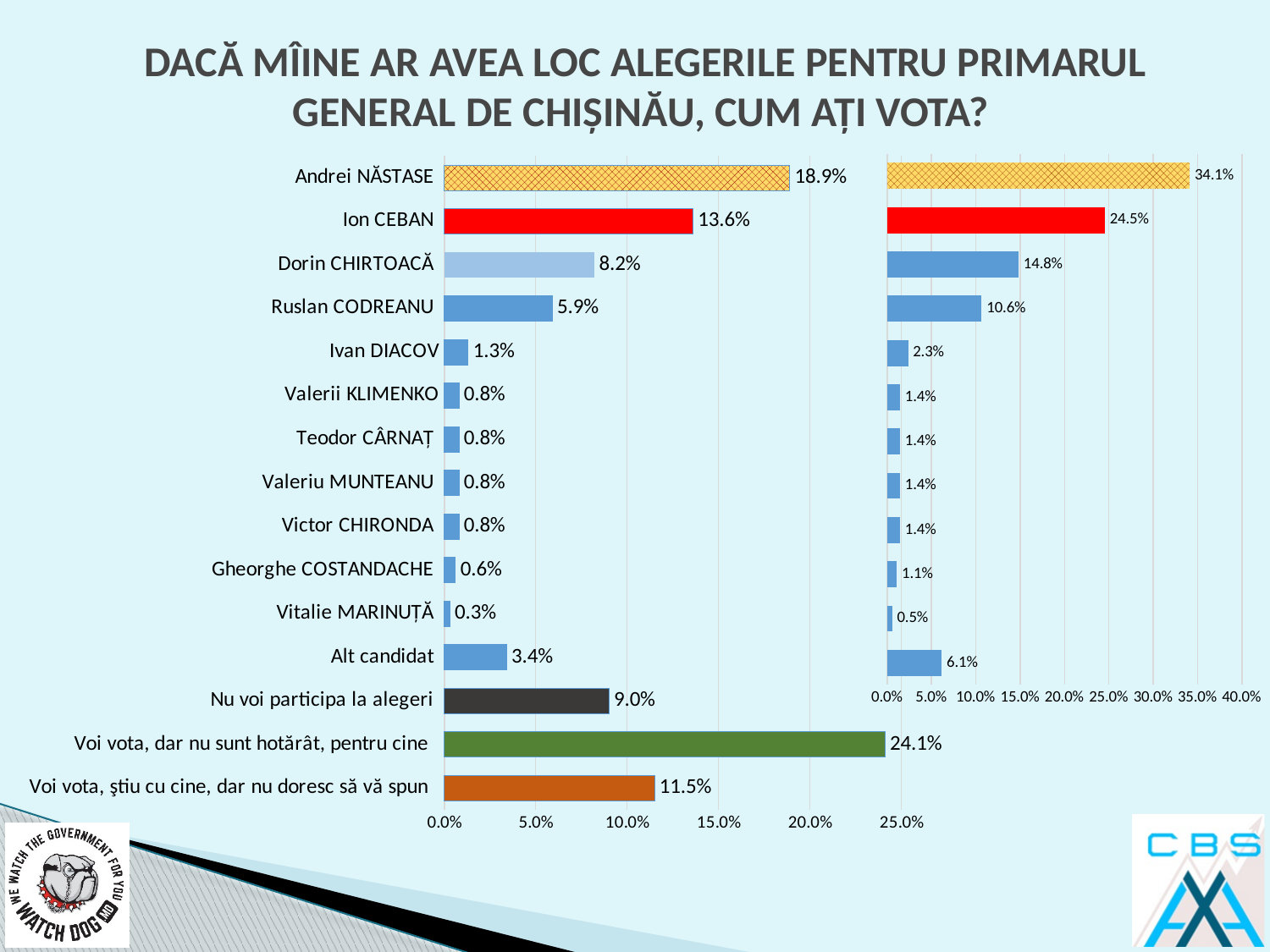
In the left-hand chart, what is the difference between Andrei NĂSTASE and Ion CEBAN? 5.3% What type of chart is used on this slide? Bar chart In the right-hand chart, what is the difference between Dorin CHIRTOACĂ and Ruslan CODREANU? 4.2% In the right-hand chart, which candidate has the highest value? Andrei NĂSTASE In the left-hand chart, which is larger: 'Nu voi participa la alegeri' or 'Voi vota, știu cu cine, dar nu doresc să vă spun'? Voi vota, știu cu cine, dar nu doresc să vă spun In the left-hand chart, what is the value for Andrei NĂSTASE? 18.9% In the right-hand chart, what is the value for Ion CEBAN? 24.5% In the left-hand chart, which category has the lowest value? Vitalie MARINUȚĂ In the left-hand chart, what is the value for 'Voi vota, dar nu sunt hotărât, pentru cine'? 24.1% How many categories are plotted in the left-hand chart? 15 How many bars are plotted in the right-hand chart? 12 In the right-hand chart, what is the value for Alt candidat? 6.1%